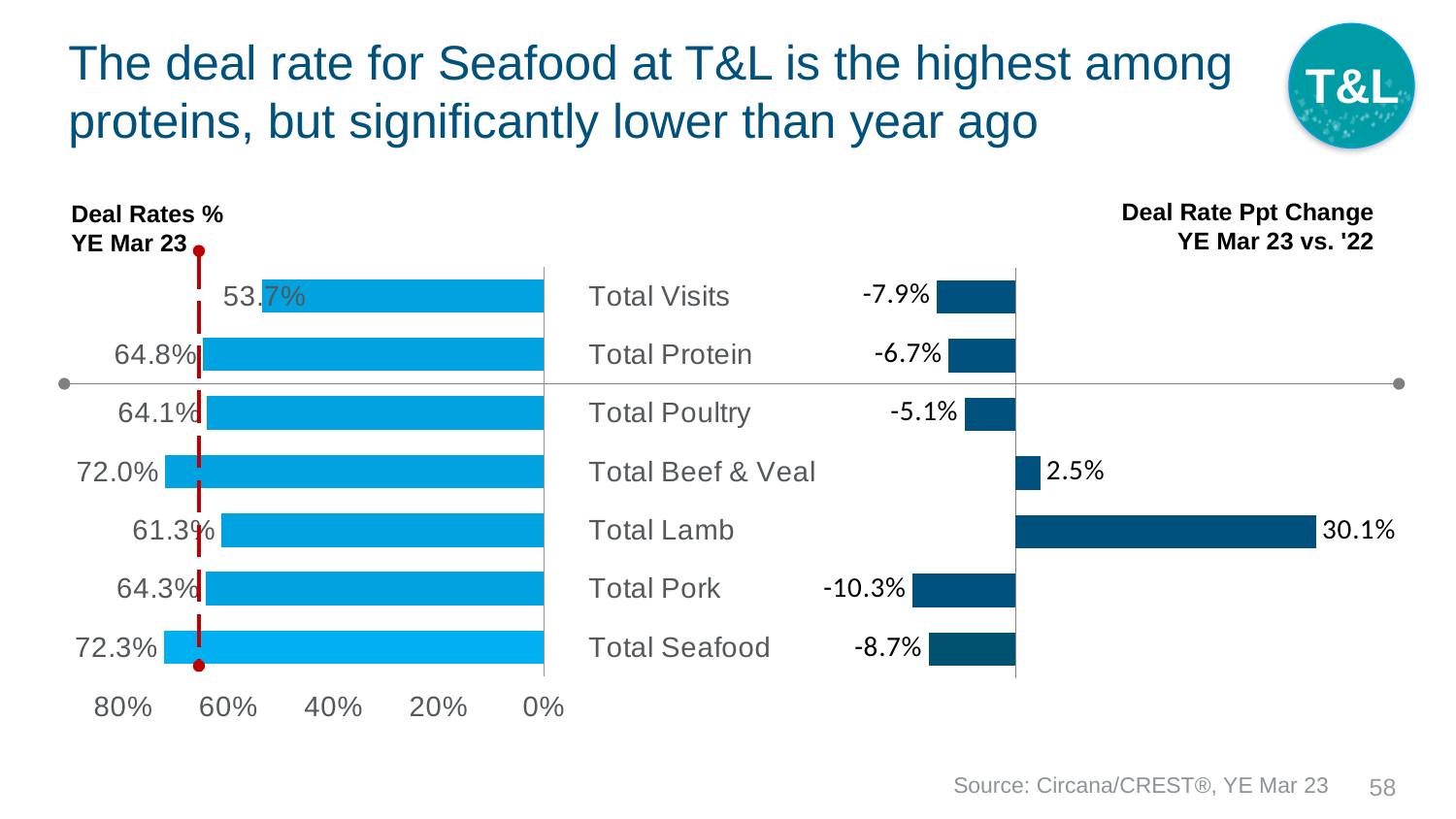
In the Deal Rate Ppt Change YE Mar 23 vs. '22 chart, which category has the highest value? Total Lamb In the Deal Rates % YE Mar 23 chart, which category has the highest deal rate? Total Seafood In the Deal Rate Ppt Change YE Mar 23 vs. '22 chart, which category has the largest decline? Total Pork What kind of chart is the Deal Rates % YE Mar 23 chart? Bar chart In the Deal Rates % YE Mar 23 chart, which category has the lowest deal rate? Total Visits In the Deal Rates % YE Mar 23 chart, what is the deal rate for Total Seafood? 72.3% In the Deal Rate Ppt Change YE Mar 23 vs. '22 chart, which is larger, the value for Total Poultry or the value for Total Protein? Total Poultry In the Deal Rates % YE Mar 23 chart, what is the deal rate for Total Visits? 53.7% In the Deal Rate Ppt Change YE Mar 23 vs. '22 chart, what is the value for Total Pork? -10.3% How many categories are shown in the Deal Rates % YE Mar 23 chart? 7 In the Deal Rate Ppt Change YE Mar 23 vs. '22 chart, what is the value for Total Lamb? 30.1% In the Deal Rates % YE Mar 23 chart, what is the difference between the deal rates for Total Seafood and Total Beef & Veal? 0.3 percentage points